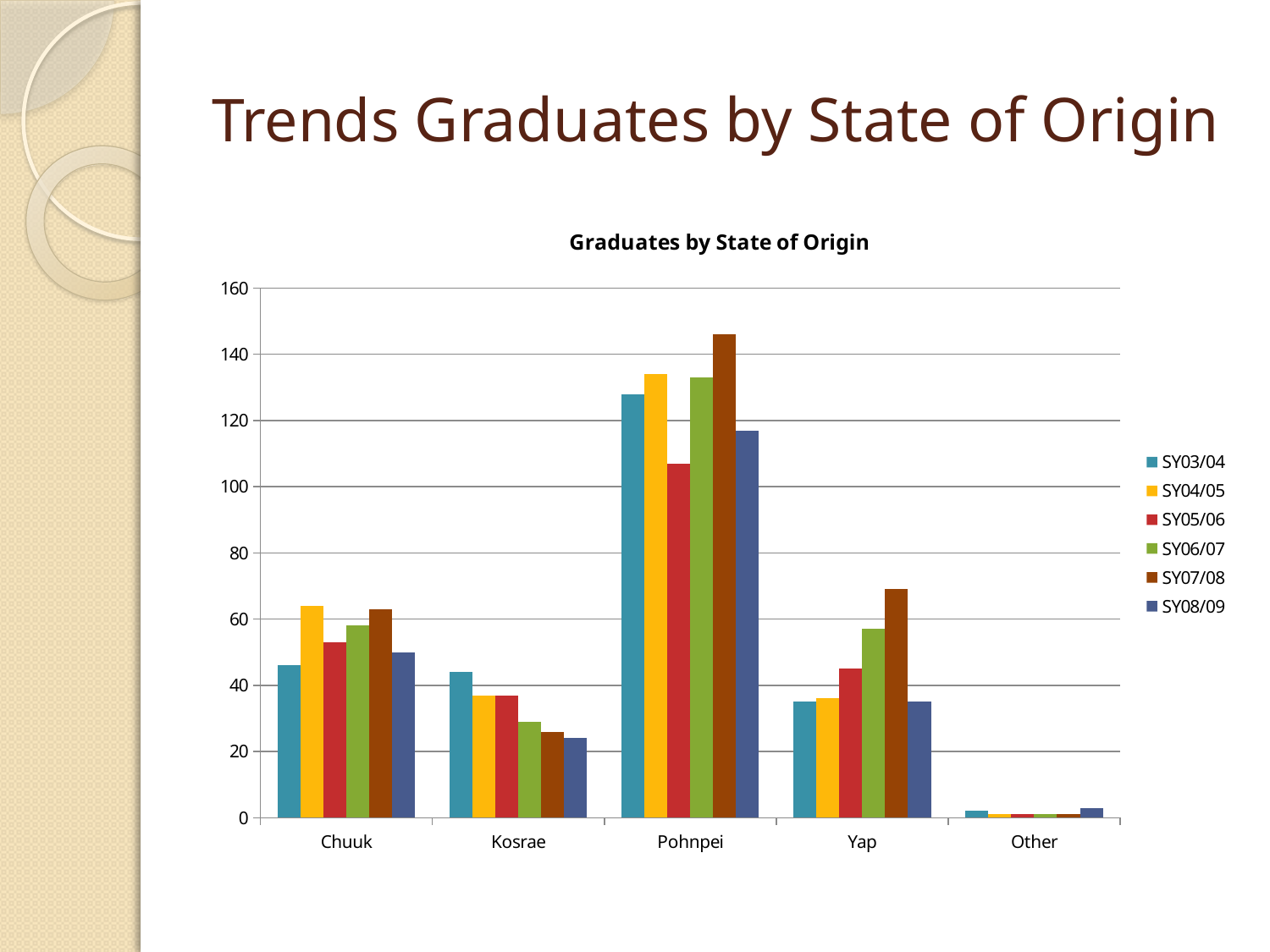
Which category has the lowest bars overall? Other How many states of origin are shown on the x axis? 5 Is the value for Pohnpei in SY07/08 greater or less than 140? greater For Chuuk, which is larger: SY03/04 or SY04/05? SY04/05 For Pohnpei, which is larger: SY05/06 or SY08/09? SY08/09 How many series does the legend list? 6 Is the value for Yap in SY07/08 greater or less than 60? greater For Kosrae, do the values rise or fall from SY03/04 to SY08/09? fall What kind of chart is shown on the slide? bar chart Which state has the highest bar for SY07/08? Pohnpei Is the value for Kosrae in SY03/04 greater or less than 40? greater What is the title of the chart? Graduates by State of Origin